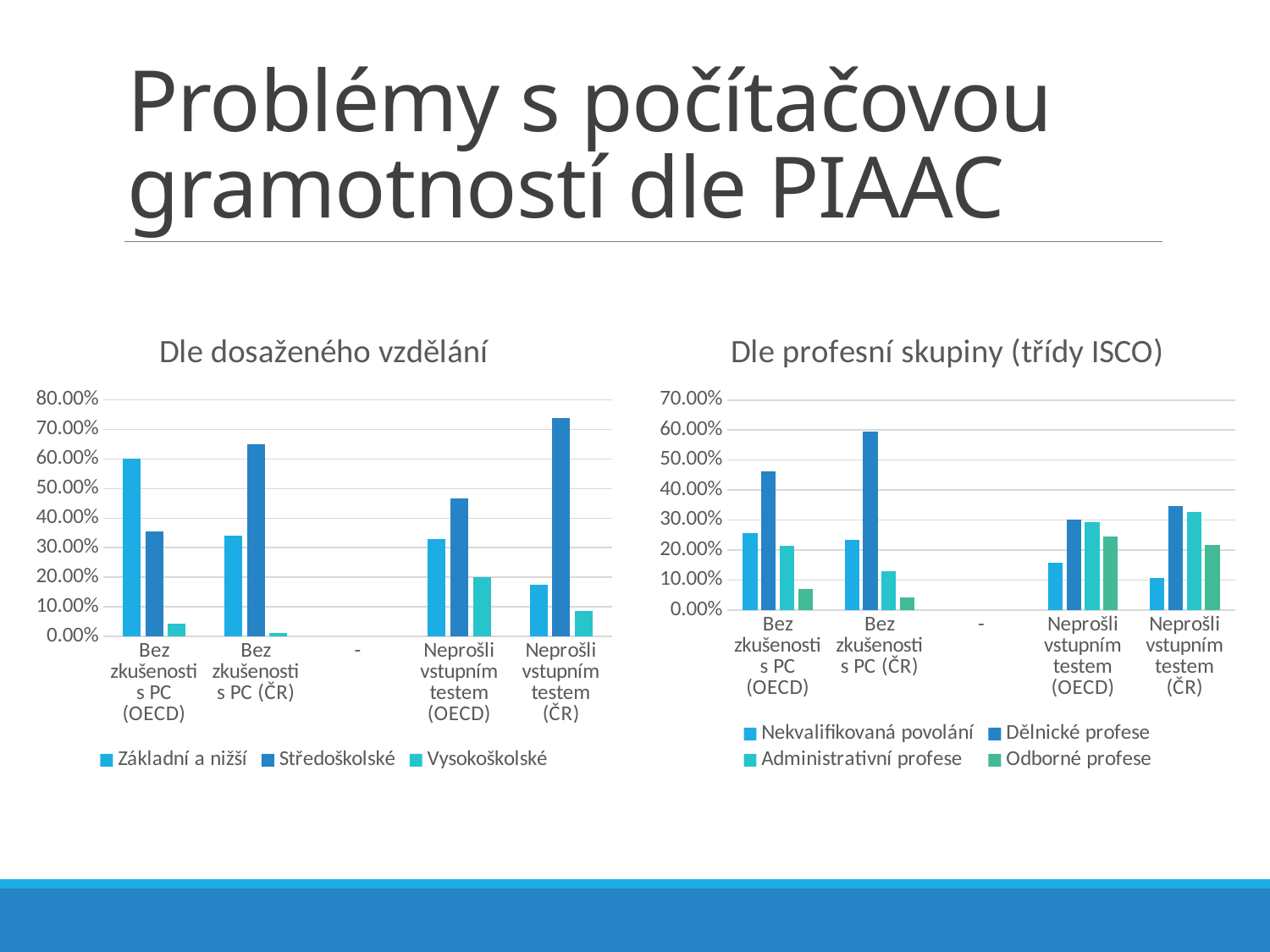
In the left chart "Dle dosaženého vzdělání", is the value for Středoškolské in the category Neprošli vstupním testem (ČR) greater or less than 70.00%? greater In the left chart "Dle dosaženého vzdělání", which series has the highest value in the category Bez zkušenosti s PC (OECD)? Základní a nižší In the right chart "Dle profesní skupiny (třídy ISCO)", for the category Neprošli vstupním testem (OECD), which is larger: Nekvalifikovaná povolání or Odborné profese? Odborné profese In the left chart "Dle dosaženého vzdělání", for the category Bez zkušenosti s PC (ČR), which is larger: Středoškolské or Základní a nižší? Středoškolské In the left chart "Dle dosaženého vzdělání", is the value for Základní a nižší in the category Bez zkušenosti s PC (OECD) greater or less than 50.00%? greater What is the title of the right chart on the slide? Dle profesní skupiny (třídy ISCO) In the right chart "Dle profesní skupiny (třídy ISCO)", is the value for Dělnické profese in the category Bez zkušenosti s PC (ČR) greater or less than 50.00%? greater In the right chart "Dle profesní skupiny (třídy ISCO)", which series has the highest value in the category Bez zkušenosti s PC (OECD)? Dělnické profese In the right chart "Dle profesní skupiny (třídy ISCO)", how many series does the legend list? 4 In the left chart "Dle dosaženého vzdělání", how many series does the legend list? 3 In the right chart "Dle profesní skupiny (třídy ISCO)", which series has the lowest value in the category Bez zkušenosti s PC (ČR)? Odborné profese What kind of chart is the left chart titled "Dle dosaženého vzdělání"? bar chart